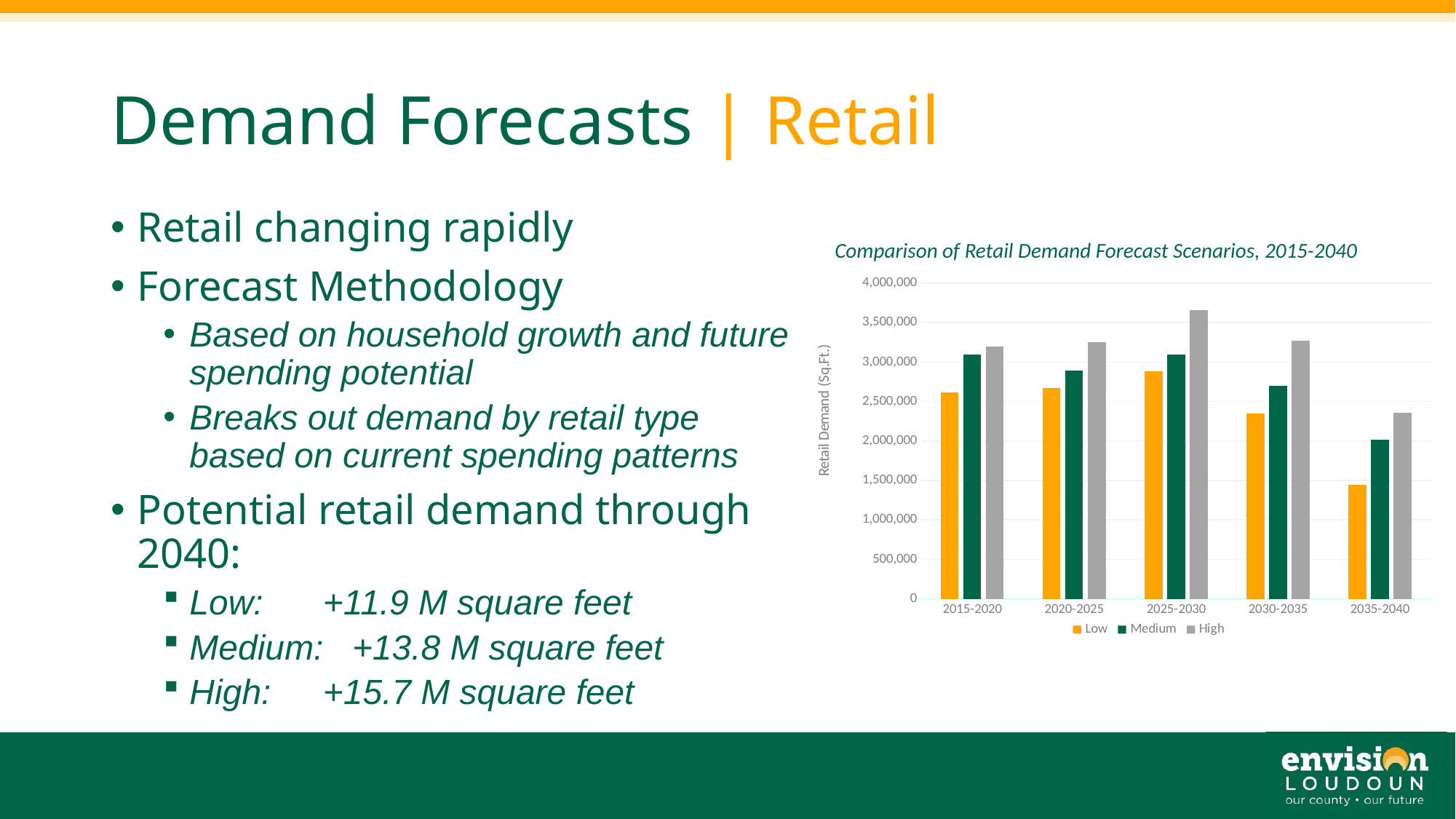
What kind of chart is shown on the slide? bar chart Is the Low value for 2015-2020 greater or less than 2,500,000? greater What is the title of the chart? Comparison of Retail Demand Forecast Scenarios, 2015-2040 How many time periods are shown on the x axis of the chart? 5 Is the High value for 2035-2040 greater or less than 2,500,000? less Do the Low scenario values rise or fall from 2025-2030 to 2035-2040? fall Is the Low value for 2035-2040 greater or less than 2,000,000? less For 2030-2035, which is larger: the Low bar or the Medium bar? Medium How many series does the chart legend list? 3 In which period is the Low scenario bar the shortest? 2035-2040 In which period is the High scenario bar the tallest? 2025-2030